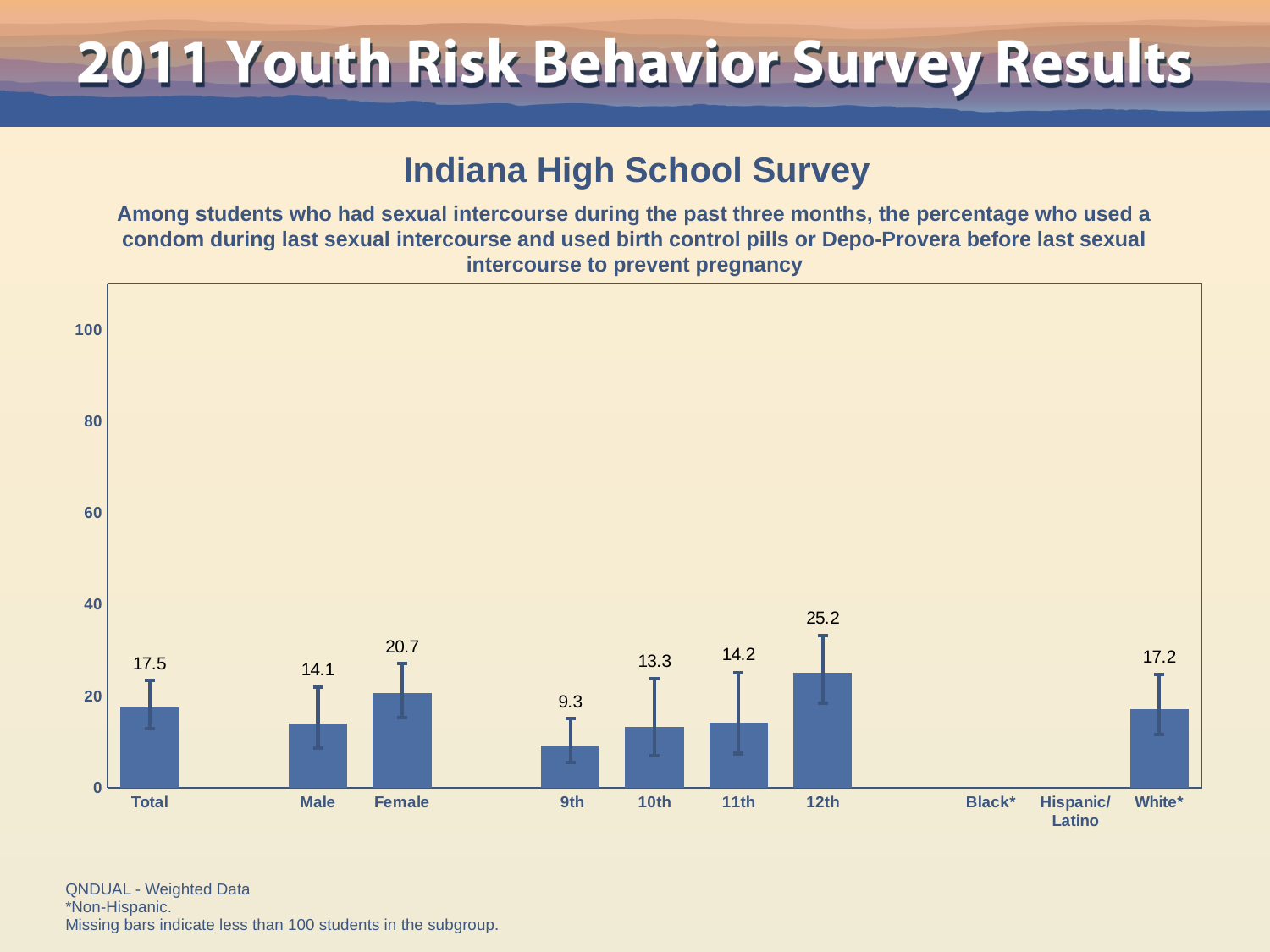
Is the value for 12th greater or less than 20? greater Which is larger, the value for 10th or the value for 11th? 11th What is the value for Total? 17.5 Which category has the highest value? 12th What kind of chart is shown? bar chart What is the value for 12th grade? 25.2 How many categories are labeled on the x axis? 10 What is the difference between the Female and Male values? 6.6 Which category with a bar has the lowest value? 9th What is the value for White*? 17.2 Which categories have no bar shown? Black* and Hispanic/Latino What is the value for Female? 20.7